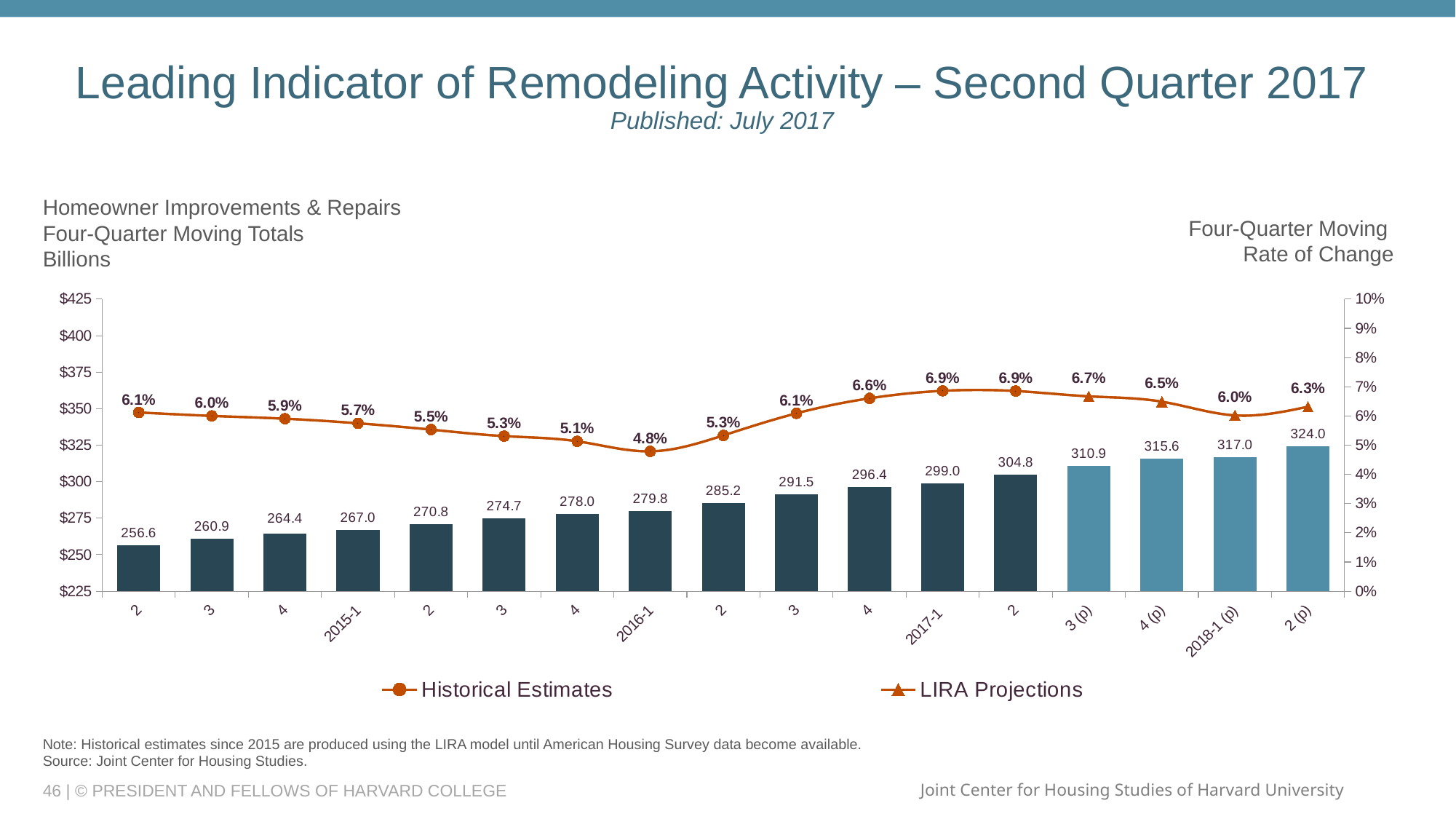
How many periods are shown on the x axis? 17 Which has the larger four-quarter moving total, 2015-1 or 2016-1? 2016-1 What kind of chart is this? Combination bar and line chart What is the projected four-quarter moving total for 2018-1 (p)? 317.0 What is the difference between the four-quarter moving totals for 2 (p) and 2017 quarter 2? 19.2 Which period has the lowest four-quarter moving rate of change? 2016-1 Do the four-quarter moving totals rise or fall from left to right along the x axis? rise Is the four-quarter moving total for 2015-1 greater or less than $275? less What is the four-quarter moving total for 2017-1? 299.0 What is the four-quarter moving rate of change for 2016-1? 4.8% How many series does the legend list? 2 Which period has the highest four-quarter moving total? 2 (p)